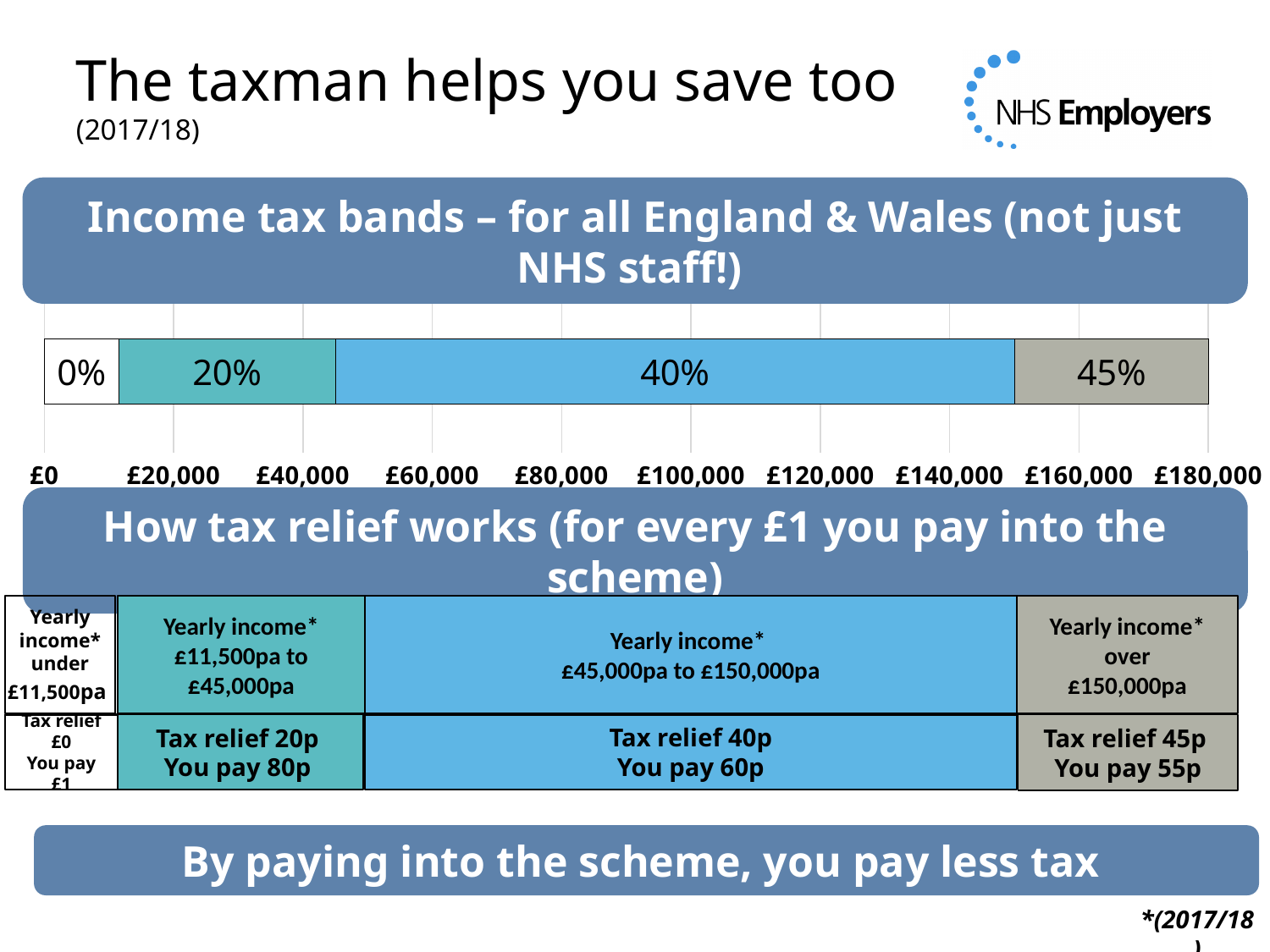
What is the label on the leftmost segment of the income tax bands bar? 0% Does the 20% band begin at an income greater or less than £20,000? less What is the title above the income tax bands chart? Income tax bands – for all England & Wales (not just NHS staff!) Which segment is wider in the income tax bands bar, the 20% band or the 40% band? 40% How many tax band segments are shown in the income tax bands bar? 4 Which tax band segment is the narrowest in the income tax bands bar? 0% What is the highest value shown on the income axis of the tax bands chart? £180,000 What is the label on the rightmost segment of the income tax bands bar? 45% What kind of chart is used to show the income tax bands? Bar chart What colour is the 40% segment in the income tax bands bar? Light blue Does the 40% band end at an income greater or less than £140,000? greater Which tax band segment is the widest in the income tax bands bar? 40%